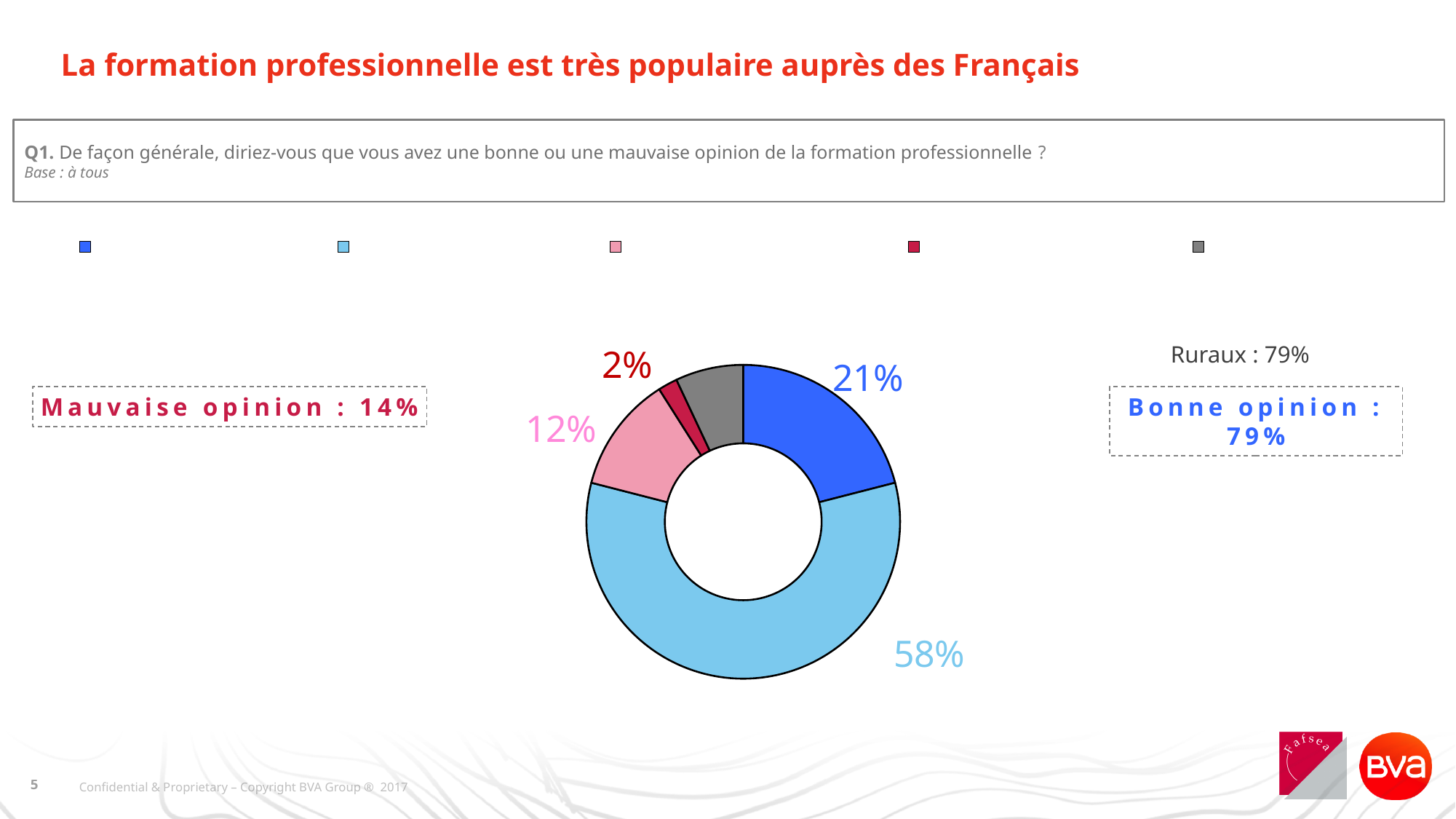
What is the title of the slide? La formation professionnelle est très populaire auprès des Français How many slices does the donut chart have? 5 What type of chart is shown on the slide? Pie chart (donut) Which is larger, the pink slice or the dark blue slice? The dark blue slice (21%) What is the difference between the light blue slice and the dark blue slice? 37 percentage points Which slice of the donut chart is the smallest? The dark red slice (2%) What percentage is shown for the dark blue slice of the donut chart? 21% Which slice of the donut chart is the largest? The light blue slice (58%) What is the combined share of the dark blue and light blue slices? 79% What percentage is shown for the dark red slice of the donut chart? 2% What percentage is shown for the light blue slice of the donut chart? 58% What percentage is shown for the pink slice of the donut chart? 12%